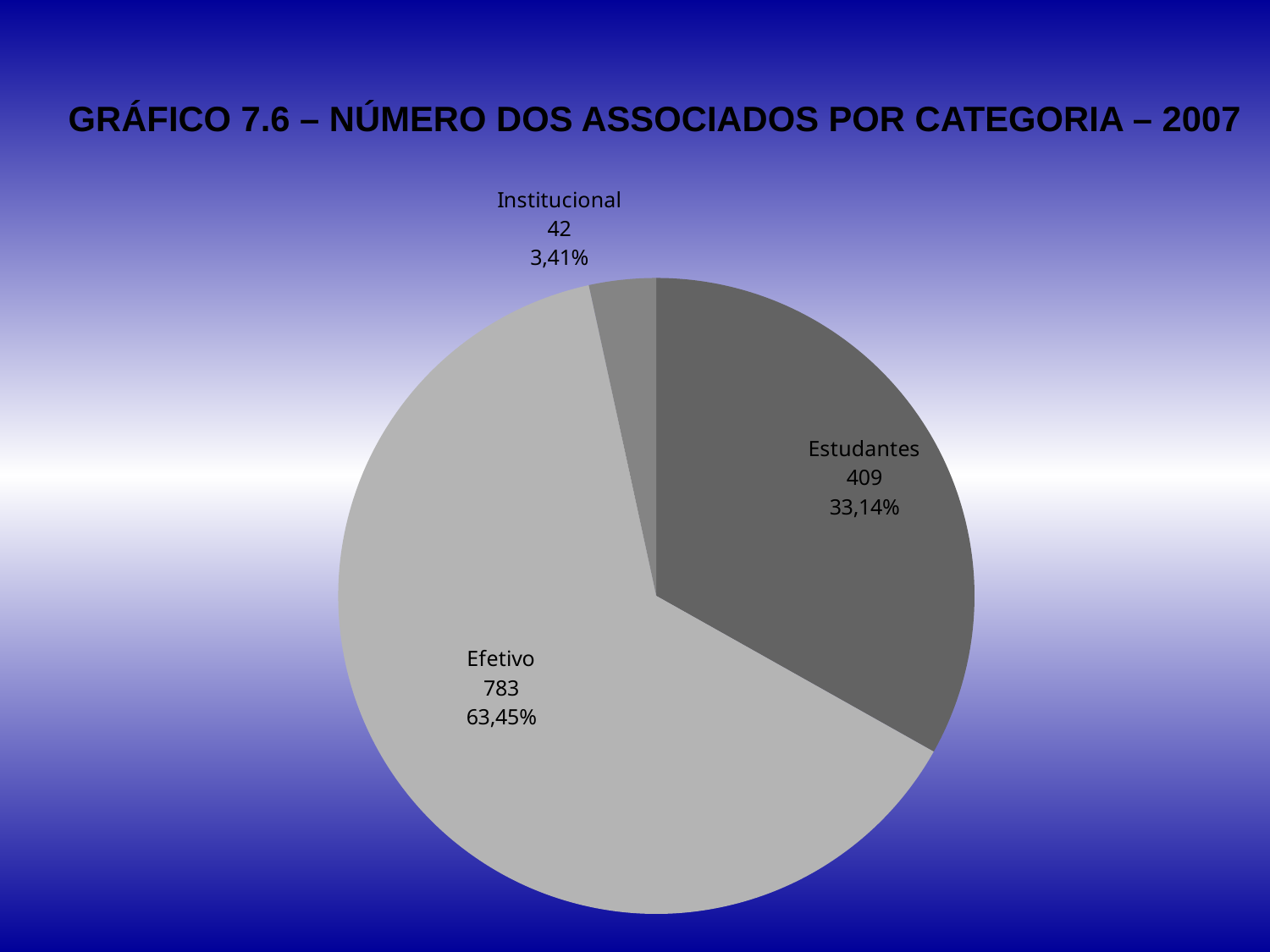
Which category has more associates, Estudantes or Institucional? Estudantes Which category has the smallest number of associates? Institucional What is the difference between the number of Efetivo and Estudantes associates? 374 What share of the pie does the Institucional slice represent? 3,41% What is the number of associates in the Estudantes category? 409 What is the number of associates in the Institucional category? 42 What is the title of the chart? GRÁFICO 7.6 – NÚMERO DOS ASSOCIADOS POR CATEGORIA – 2007 What is the number of associates in the Efetivo category? 783 How many categories does the pie chart show? 3 What kind of chart is shown on the slide? pie chart What share of the pie does the Estudantes slice represent? 33,14% Which category has the largest number of associates? Efetivo